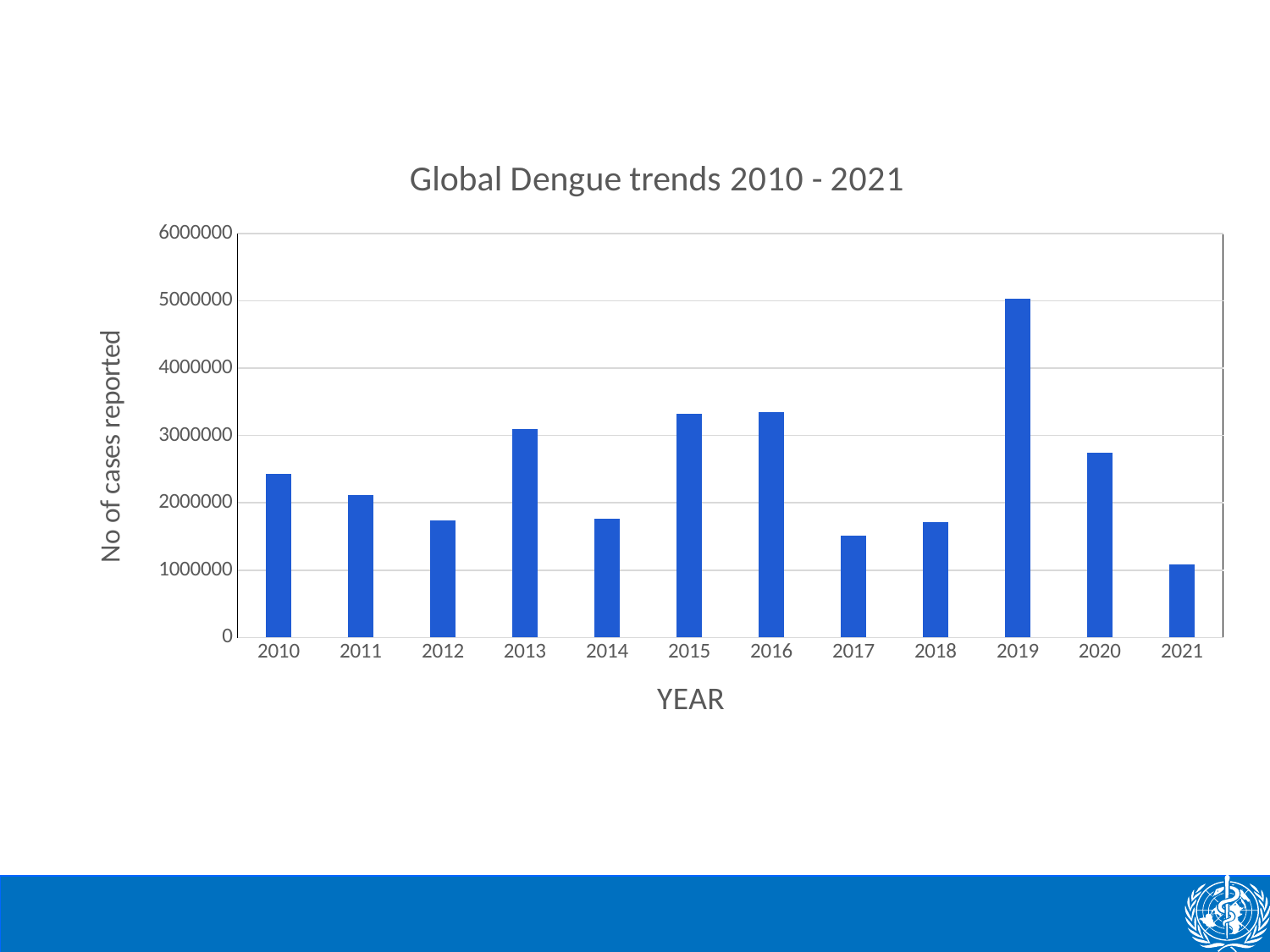
Which year has more cases reported, 2013 or 2014? 2013 What is the label of the y axis? No of cases reported How many years are shown on the x axis? 12 Which year has the highest number of cases reported? 2019 What type of chart is shown on the slide? bar chart Is the value for 2010 greater or less than 2000000? greater What is the title of the chart? Global Dengue trends 2010 - 2021 Is the value for 2019 greater or less than 4000000? greater Which year has more cases reported, 2020 or 2021? 2020 Is the value for 2017 greater or less than 2000000? less Which year has the lowest number of cases reported? 2021